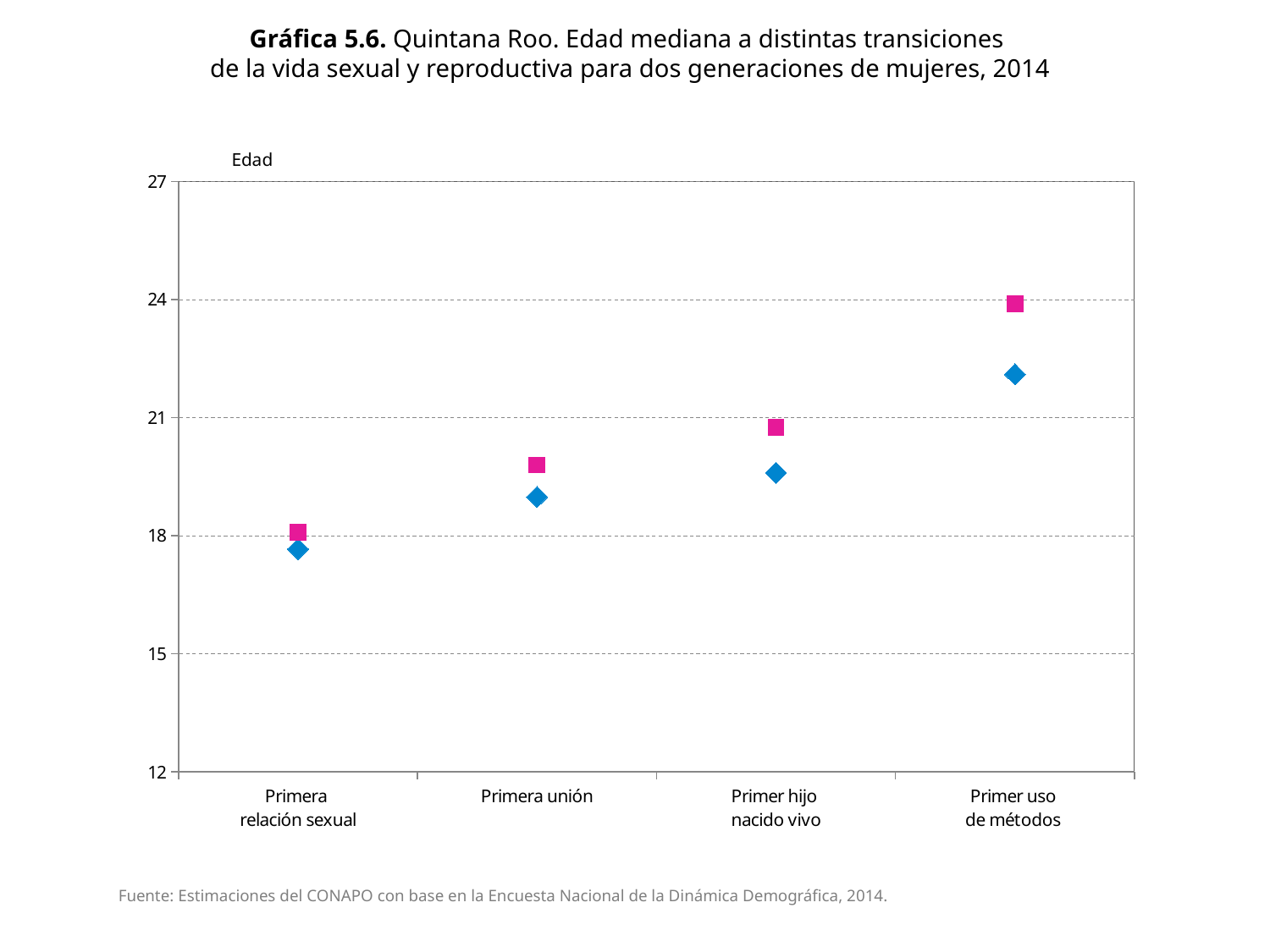
Do the plotted ages rise or fall from Primera relación sexual to Primer uso de métodos? rise How many marker series are plotted on the chart? 2 Is the value of the blue diamond for Primer uso de métodos greater or less than 21? greater Which category has the lowest plotted values? Primera relación sexual Is the value of the pink square for Primera unión greater or less than 21? less How many transition categories are shown on the x axis? 4 Is the value of the blue diamond for Primera relación sexual greater or less than 18? less Which category has the highest plotted values? Primer uso de métodos For Primer uso de métodos, which marker is higher, the pink square or the blue diamond? pink square What kind of chart is shown on the slide? scatter chart What is the label of the vertical axis? Edad